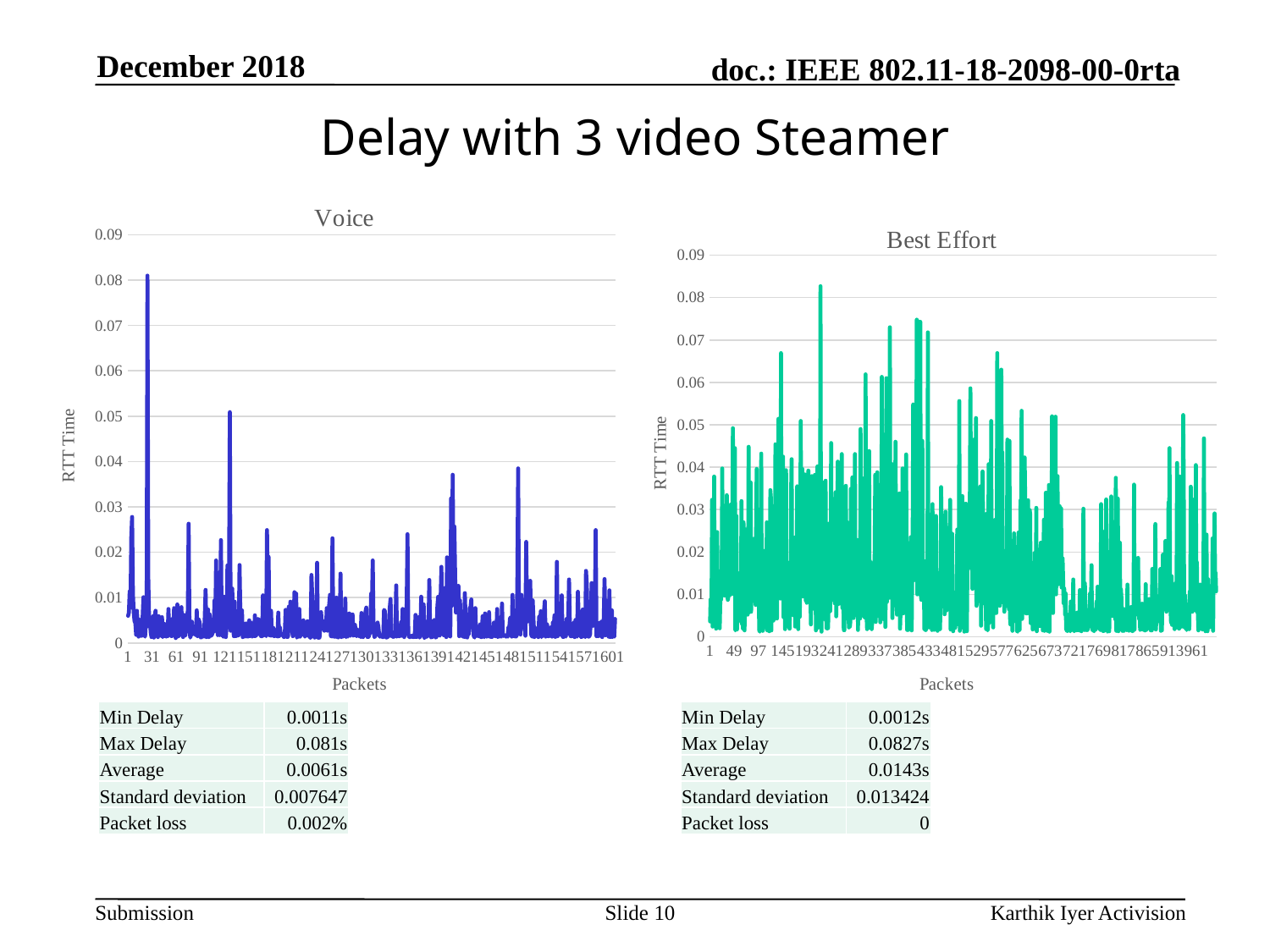
What is the y-axis title of the Best Effort chart? RTT Time How many data series are plotted in the Voice chart? 1 How many data series are plotted in the Best Effort chart? 1 What kind of chart is the Best Effort chart? line chart What is the x-axis title of the Voice chart? Packets In the Best Effort chart, is the highest peak greater or less than 0.07? greater Which chart shows generally higher RTT values across the packets, Voice or Best Effort? Best Effort What kind of chart is the Voice chart? line chart In the Voice chart, is the highest peak greater or less than 0.07? greater In the Voice chart, is the second-highest peak (near packet 121) greater or less than 0.06? less